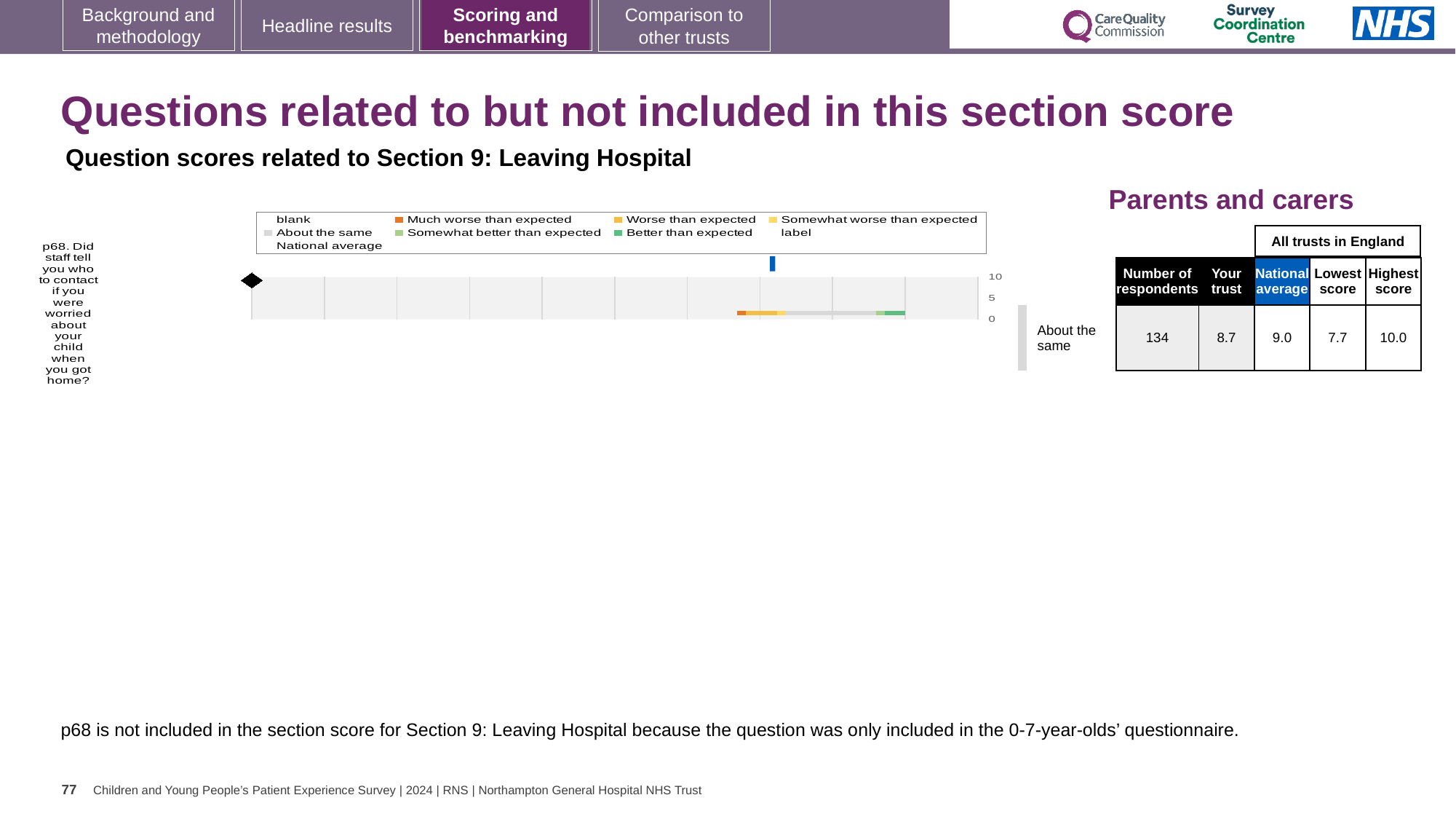
How many survey questions are plotted in the chart? 1 What is the highest tick value shown on the chart's score axis? 10 Which legend entry is shown in orange in the chart? Much worse than expected What is the difference between the highest score and the lowest score for p68 in the table beside the chart? 2.3 According to the table beside the chart, what is the national average score for p68? 9.0 According to the table beside the chart, what is the highest score among all trusts in England for p68? 10.0 What benchmark category label is shown next to the chart for the trust's p68 result? About the same What kind of chart is used to show the p68 question score? bar chart For p68, which is larger: the 'Your trust' score or the national average? National average According to the table beside the chart, what is the 'Your trust' score for p68? 8.7 According to the table beside the chart, what is the lowest score among all trusts in England for p68? 7.7 How many respondents answered question p68, according to the table beside the chart? 134